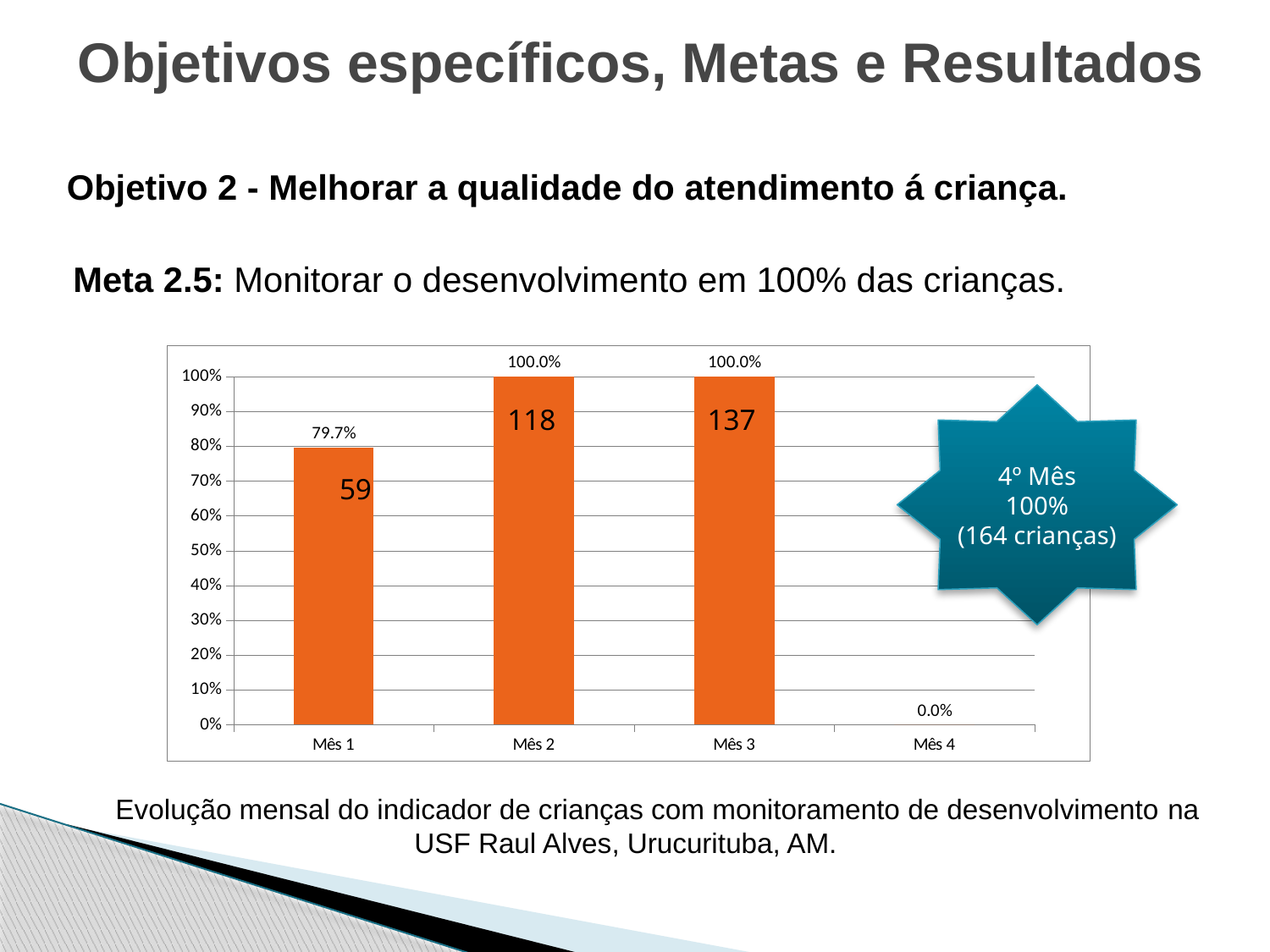
What kind of chart is shown on the slide? bar chart Which month has the lowest percentage in the chart? Mês 4 What number is printed inside the bar for Mês 3? 137 Is the value for Mês 1 greater or less than 70%? greater What percentage is shown for Mês 2? 100.0% What percentage is shown for Mês 4 in the chart? 0.0% What is the difference in percentage points between Mês 2 and Mês 1? 20.3 How many months (categories) are shown on the x axis? 4 What number is printed inside the bar for Mês 1? 59 According to the star callout, how many children correspond to 100% in the 4º Mês? 164 crianças What percentage is shown for Mês 1? 79.7% Which is larger, the percentage for Mês 1 or for Mês 3? Mês 3